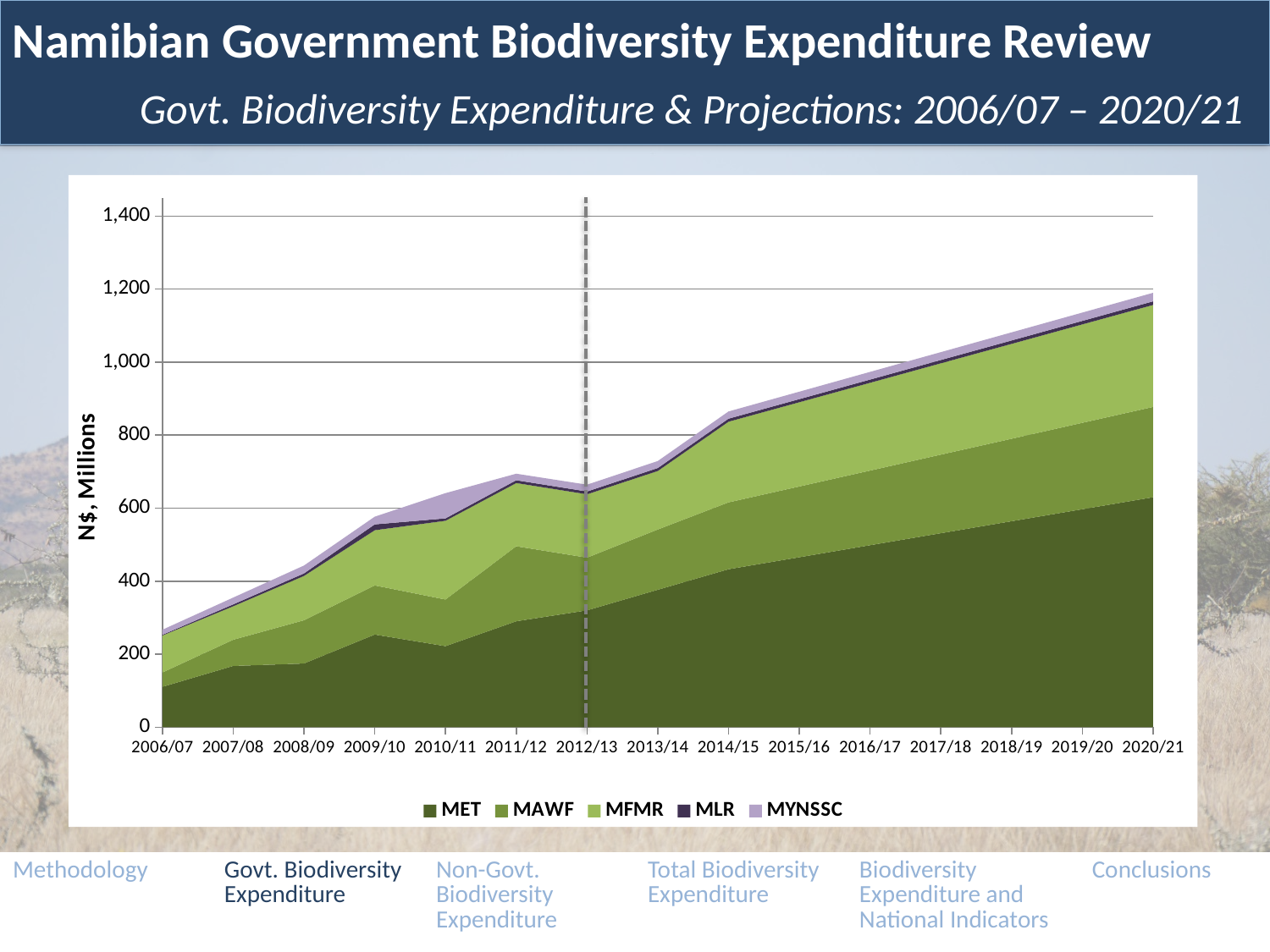
What kind of chart is shown on the slide? Stacked area chart Is the total expenditure for 2012/13 greater or less than 800? less Does the total expenditure generally rise or fall from 2006/07 to 2020/21? rise Which is larger, the total expenditure in 2014/15 or in 2010/11? 2014/15 How many fiscal years are plotted along the x axis? 15 Is the total expenditure for 2006/07 greater or less than 400? less How many series does the legend list? 5 Which fiscal year has the highest total expenditure? 2020/21 What is the label on the y axis? N$, Millions Is the total expenditure for 2020/21 greater or less than 1,000? greater Which series are listed in the legend? MET, MAWF, MFMR, MLR, MYNSSC Which fiscal year has the lowest total expenditure? 2006/07